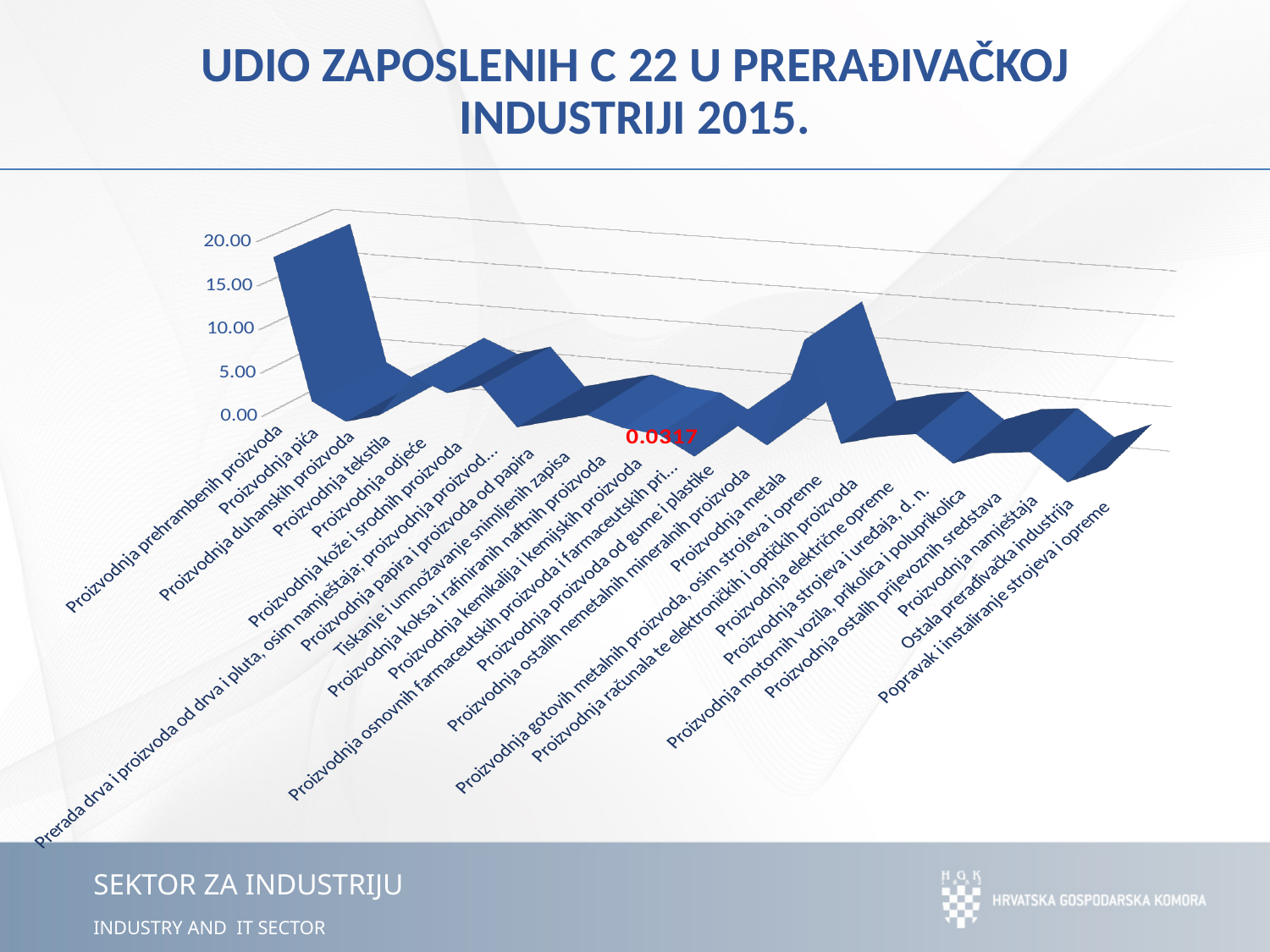
What is the title of the chart on the slide? UDIO ZAPOSLENIH C 22 U PRERAĐIVAČKOJ INDUSTRIJI 2015. What kind of chart is shown on the slide? 3D line chart Is the value for Proizvodnja gotovih metalnih proizvoda, osim strojeva i opreme greater or less than 5? greater What is the highest tick value shown on the vertical axis of the chart? 20.00 Is the value for Proizvodnja prehrambenih proizvoda greater or less than 15? greater What is the only data label value printed on the chart? 0.0317 Which category has the highest value in the chart? Proizvodnja prehrambenih proizvoda Which is larger, the value for Proizvodnja gotovih metalnih proizvoda, osim strojeva i opreme or the value for Proizvodnja metala? Proizvodnja gotovih metalnih proizvoda, osim strojeva i opreme Does the value fall or rise from Proizvodnja prehrambenih proizvoda to Proizvodnja pića? fall Is the value for Proizvodnja duhanskih proizvoda greater or less than 10? less How many categories are plotted along the x axis of the chart? 24 Which is larger, the value for Proizvodnja prehrambenih proizvoda or the value for Proizvodnja gotovih metalnih proizvoda, osim strojeva i opreme? Proizvodnja prehrambenih proizvoda